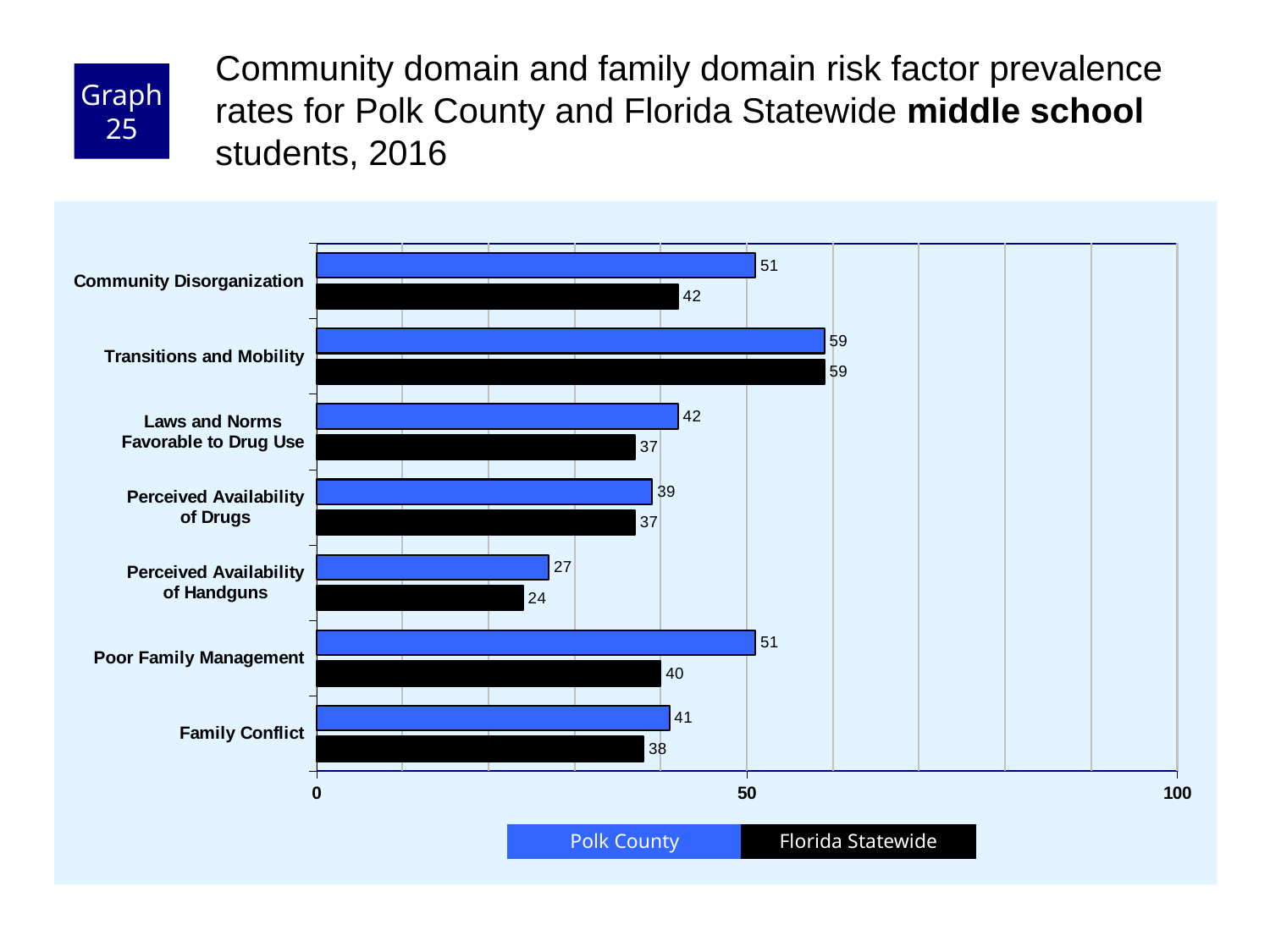
Which is larger for Family Conflict, the Polk County value or the Florida Statewide value? Polk County Which risk factor has the highest Polk County value? Transitions and Mobility What is the difference between the Polk County and Florida Statewide values for Community Disorganization? 9 What kind of chart is shown on the slide? Bar chart Is the Polk County value for Transitions and Mobility greater or less than 50? greater What is the Florida Statewide value for Perceived Availability of Handguns? 24 How many risk factors are shown on the chart? 7 What is the Polk County value for Community Disorganization? 51 What is the Florida Statewide value for Poor Family Management? 40 What is the difference between the Polk County and Florida Statewide values for Poor Family Management? 11 How many series does the legend list? 2 Which risk factor has the lowest Florida Statewide value? Perceived Availability of Handguns